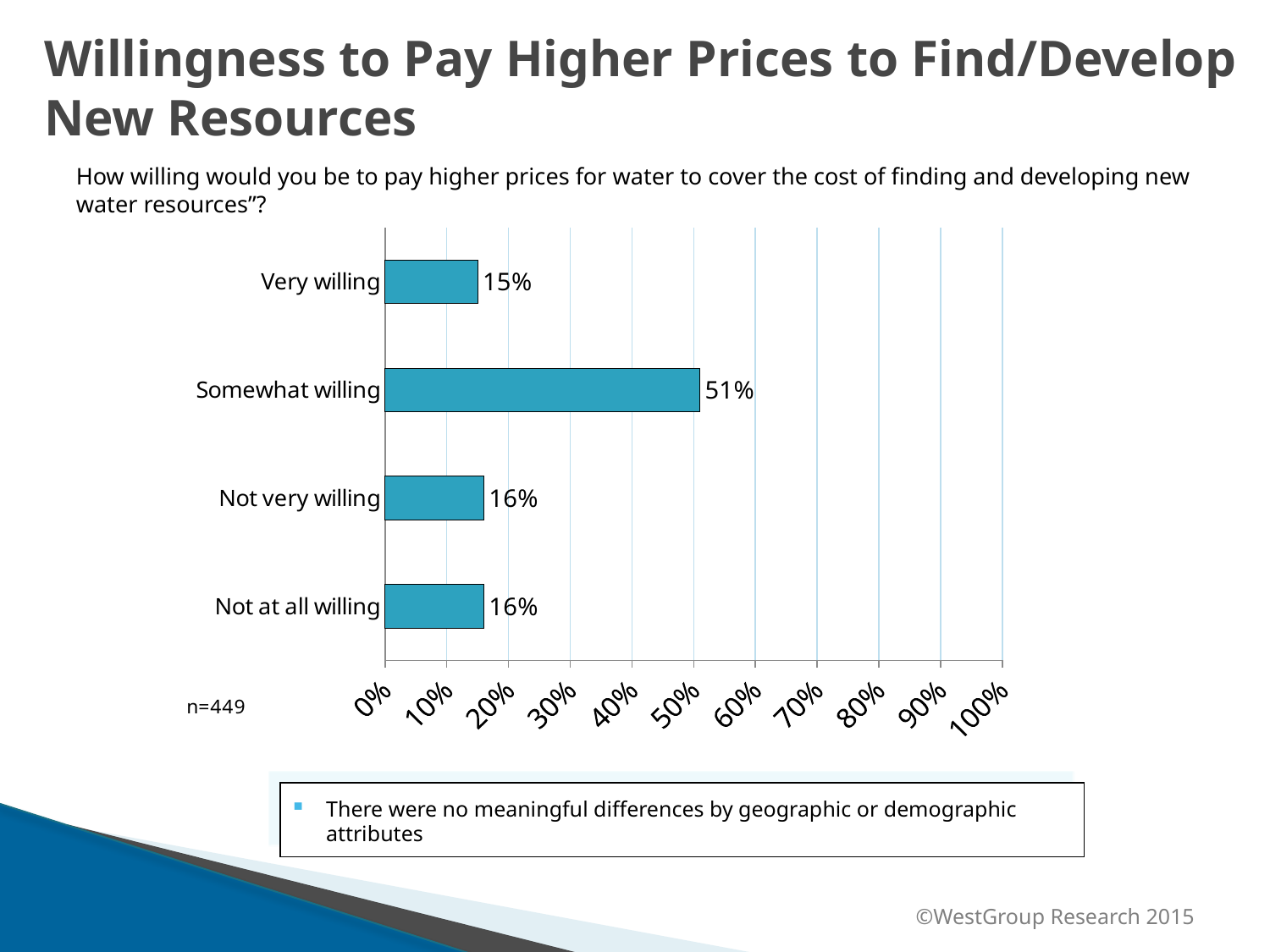
Is the value for "Somewhat willing" greater or less than 50%? greater Which is larger, the percentage for "Very willing" or for "Somewhat willing"? Somewhat willing What percentage of respondents were "Somewhat willing" to pay higher prices? 51% What is the maximum value shown on the percentage axis? 100% Which response category has the lowest percentage? Very willing What percentage of respondents were "Not at all willing"? 16% What is the sample size (n) shown for the chart? 449 What type of chart is shown on the slide? Bar chart Which response category has the highest percentage? Somewhat willing What is the difference between the "Somewhat willing" and "Not very willing" percentages? 35% How many response categories are shown in the chart? 4 What percentage of respondents were "Very willing" to pay higher prices? 15%